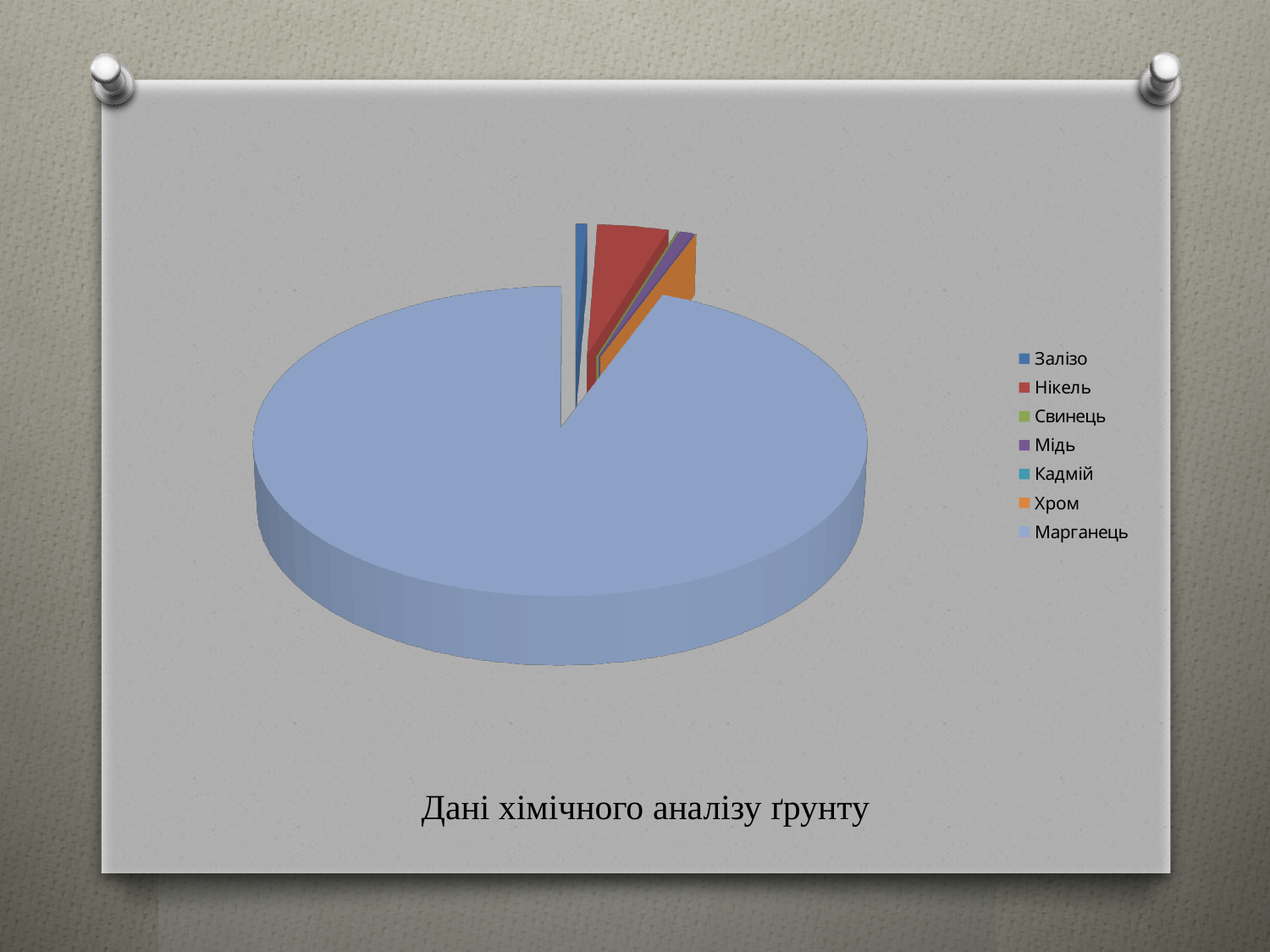
Which slice is larger, Нікель or Хром? Нікель How many categories does the pie chart's legend list? 7 Which category is listed last in the pie chart's legend? Марганець What is the title text shown below the pie chart? Дані хімічного аналізу ґрунту Which slice is larger, Марганець or Хром? Марганець What kind of chart is shown on the slide? pie chart Which slice is larger, Марганець or Нікель? Марганець Which category is shown in red in the pie chart's legend? Нікель Which category has the largest slice of the pie chart? Марганець